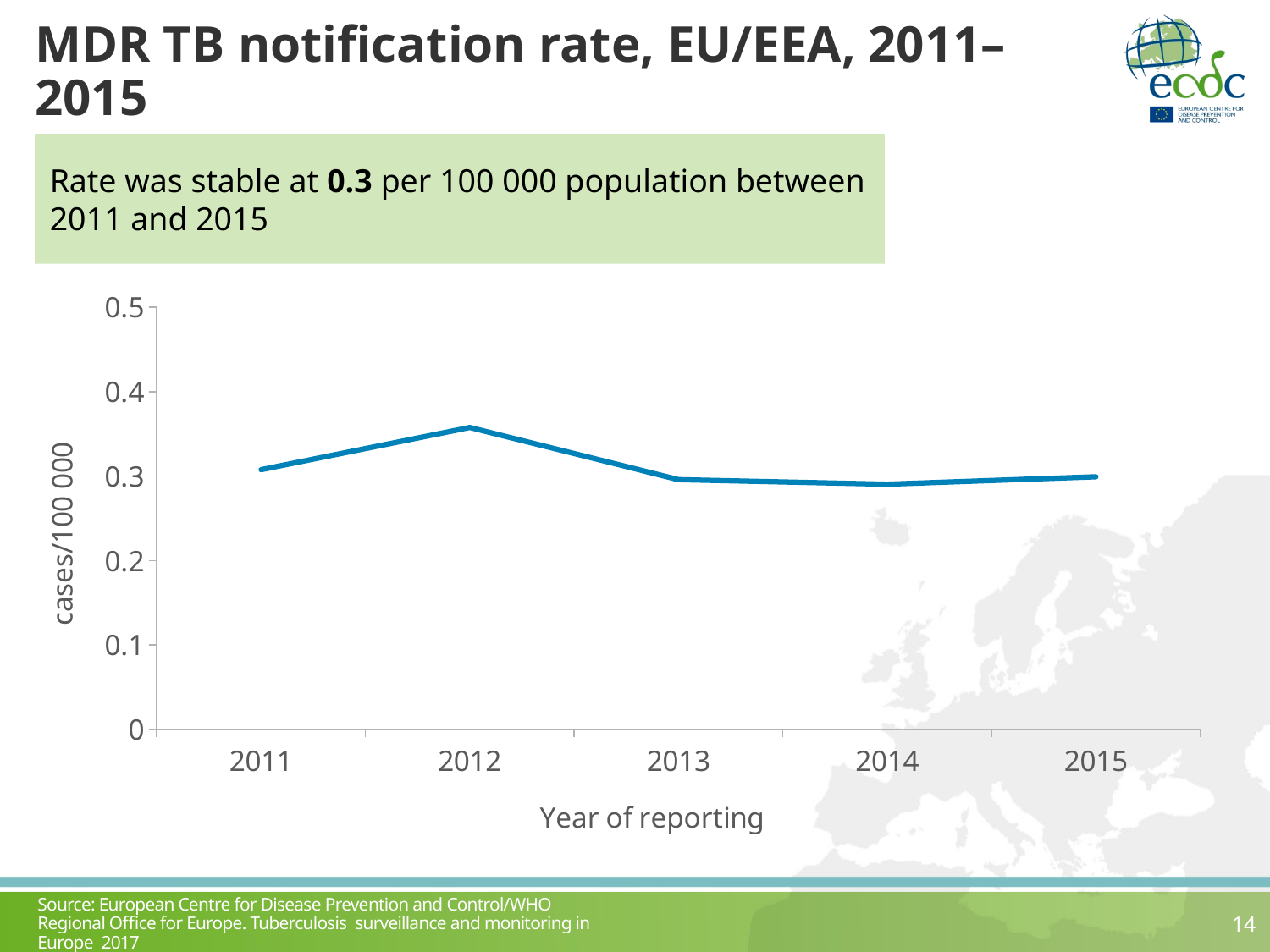
Which is larger, the value for 2012 or the value for 2013? 2012 Does the line rise or fall from 2011 to 2012? rise Is the value for 2012 greater or less than 0.3? greater Is the value for 2015 greater or less than 0.4? less How many years are plotted on the x axis? 5 Is the value for 2012 greater or less than 0.4? less What kind of chart is shown on the slide? line chart Which year has the highest MDR TB notification rate? 2012 What is the label of the y axis? cases/100 000 What is the label of the x axis? Year of reporting Does the line rise or fall from 2012 to 2013? fall